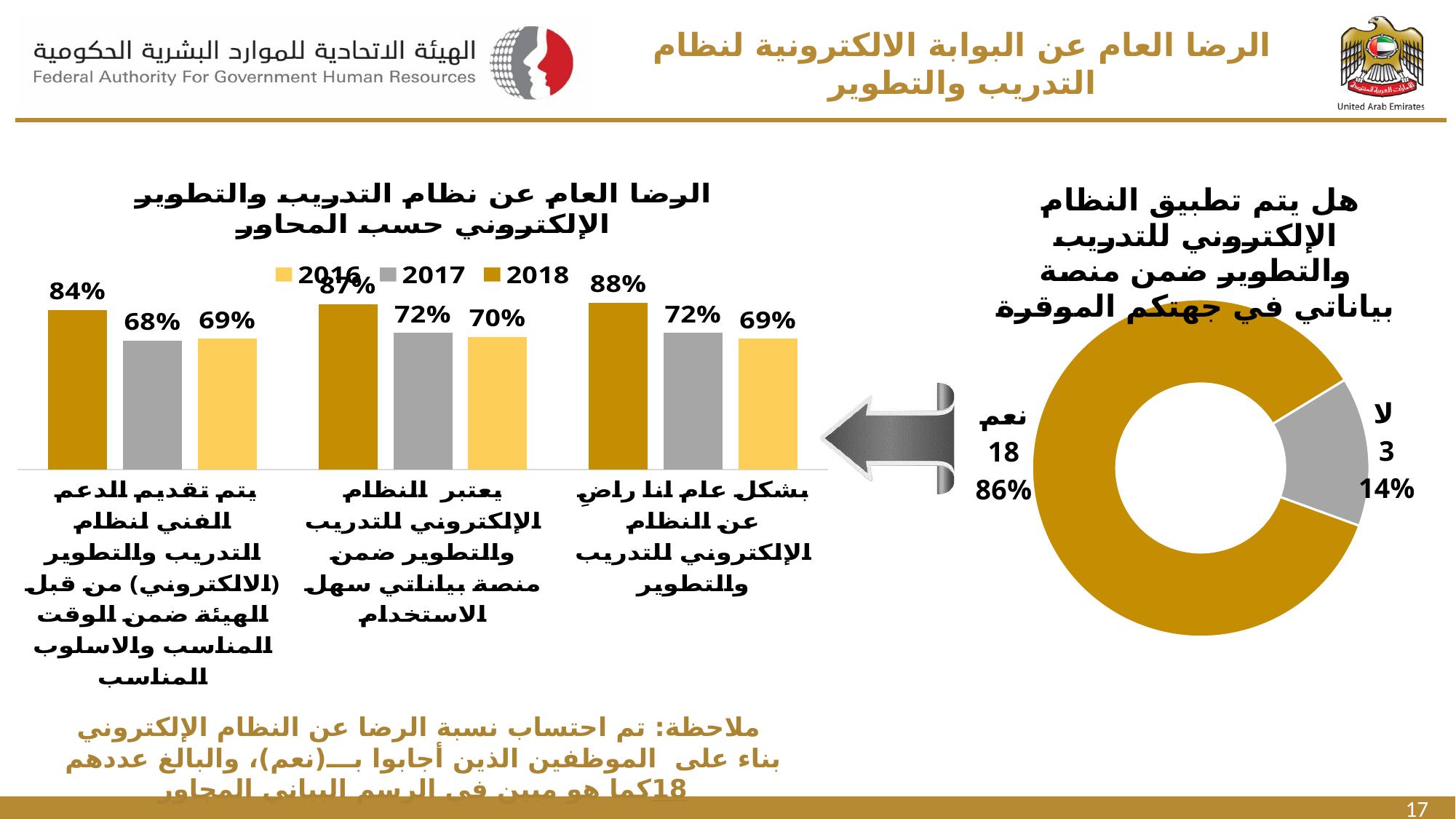
In the doughnut chart on the right, what percentage share does 'نعم' have? 86% In the doughnut chart on the right, what is the count for 'لا'? 3 How many series does the legend of the bar chart on the left list? 3 In the bar chart on the left, which category has the highest 2018 value? بشكل عام انا راضٍ عن النظام الإلكتروني للتدريب والتطوير In the bar chart on the left, what is the 2018 value for the category 'بشكل عام انا راضٍ عن النظام الإلكتروني للتدريب والتطوير'? 88% In the bar chart on the left, what is the 2016 value for the category 'يعتبر النظام الإلكتروني للتدريب والتطوير ضمن منصة بياناتي سهل الاستخدام'? 70% In the bar chart on the left, what is the difference between the 2018 and 2017 values for the category 'بشكل عام انا راضٍ عن النظام الإلكتروني للتدريب والتطوير'? 16% What type of chart is shown on the right side of the slide? Doughnut chart In the bar chart on the left, for the category 'يتم تقديم الدعم الفني لنظام التدريب والتطوير (الالكتروني)', which is larger: the 2016 value or the 2017 value? 2016 In the bar chart on the left, which category has the lowest 2017 value? يتم تقديم الدعم الفني لنظام التدريب والتطوير (الالكتروني) How many categories are shown in the bar chart on the left? 3 In the bar chart on the left, what is the 2017 value for the category 'يتم تقديم الدعم الفني لنظام التدريب والتطوير (الالكتروني)'? 68%